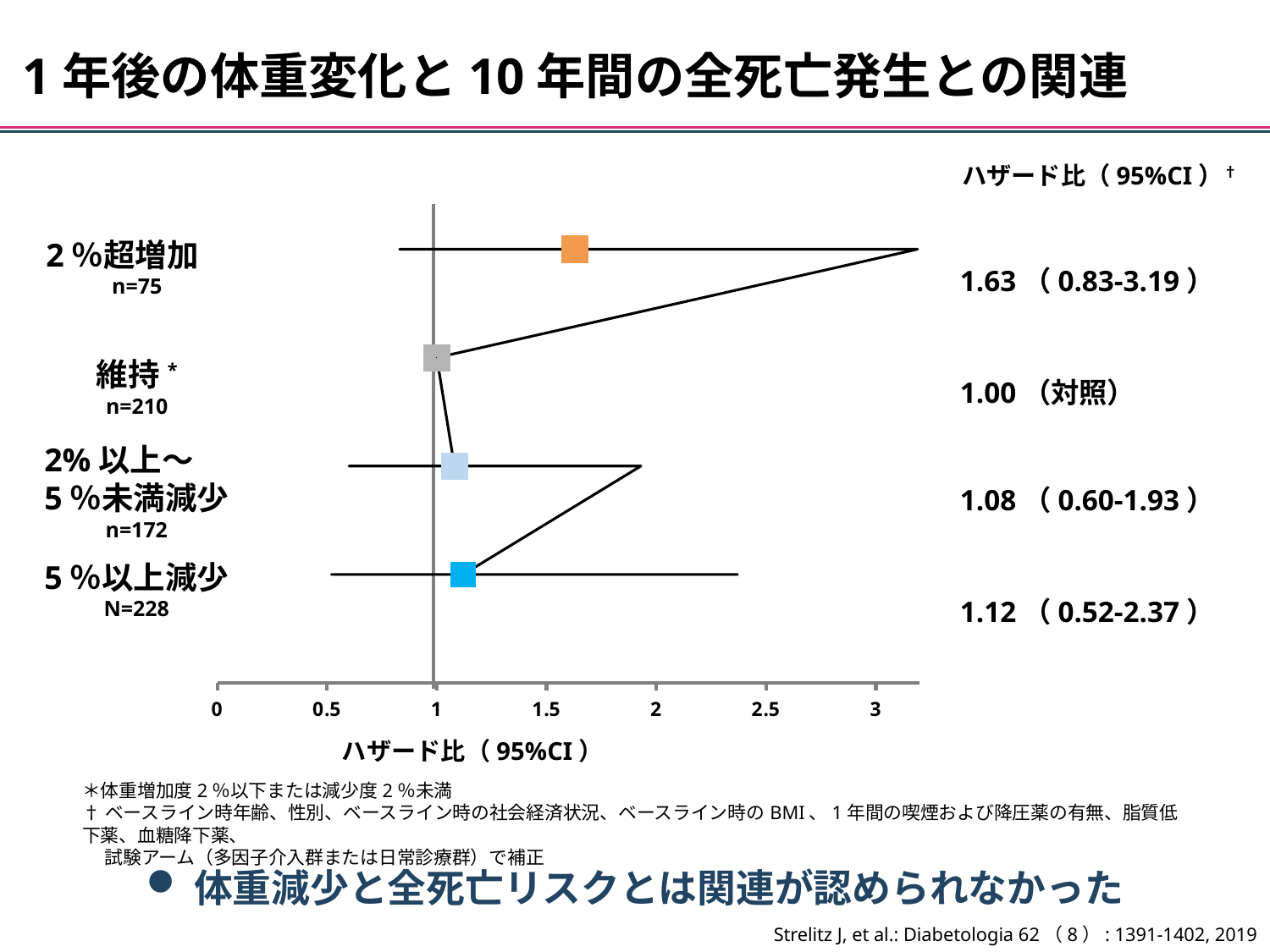
Is the hazard ratio point estimate for the 2%超増加 group greater or less than 1.5? greater Which weight-change group has the highest hazard ratio? 2%超増加 What is the hazard ratio for the 2%超増加 group? 1.63 What is the difference between the hazard ratio of the 2%超増加 group and the 維持 reference group? 0.63 What kind of chart is shown on the slide? Forest plot What is the hazard ratio for the 2%以上～5%未満減少 group? 1.08 What is the 95% CI for the 5%以上減少 group? 0.52-2.37 Which has a larger hazard ratio, the 5%以上減少 group or the 2%以上～5%未満減少 group? 5%以上減少 What is the sample size (n) for the 維持 group? n=210 What is the label of the x axis of the chart? ハザード比（95%CI） Which weight-change group has the lowest hazard ratio? 維持 How many weight-change groups are plotted in the chart? 4